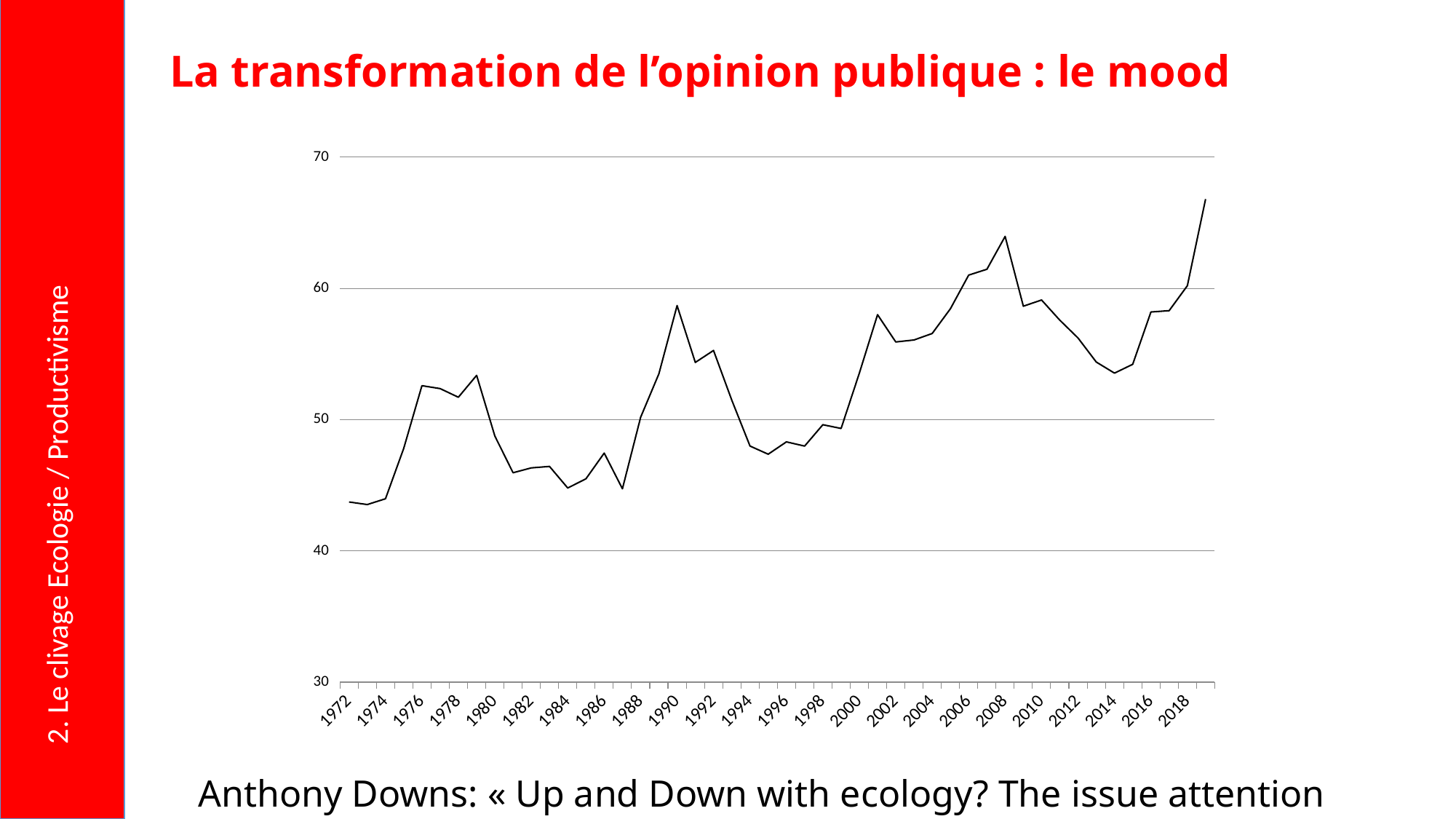
Is the value for 1990 greater or less than 50? greater Which year has the larger value, 1980 or 1990? 1990 Is the value for 1994 greater or less than 50? less In which year does the line reach its highest value? 2019 Is the value for 2014 greater or less than 60? less Overall, does the line rise or fall from 1972 to 2019? rise What kind of chart is shown on the slide? line chart Does the line rise or fall between 2008 and 2014? fall What is the highest value shown on the y axis? 70 Which year has the larger value, 1994 or 2004? 2004